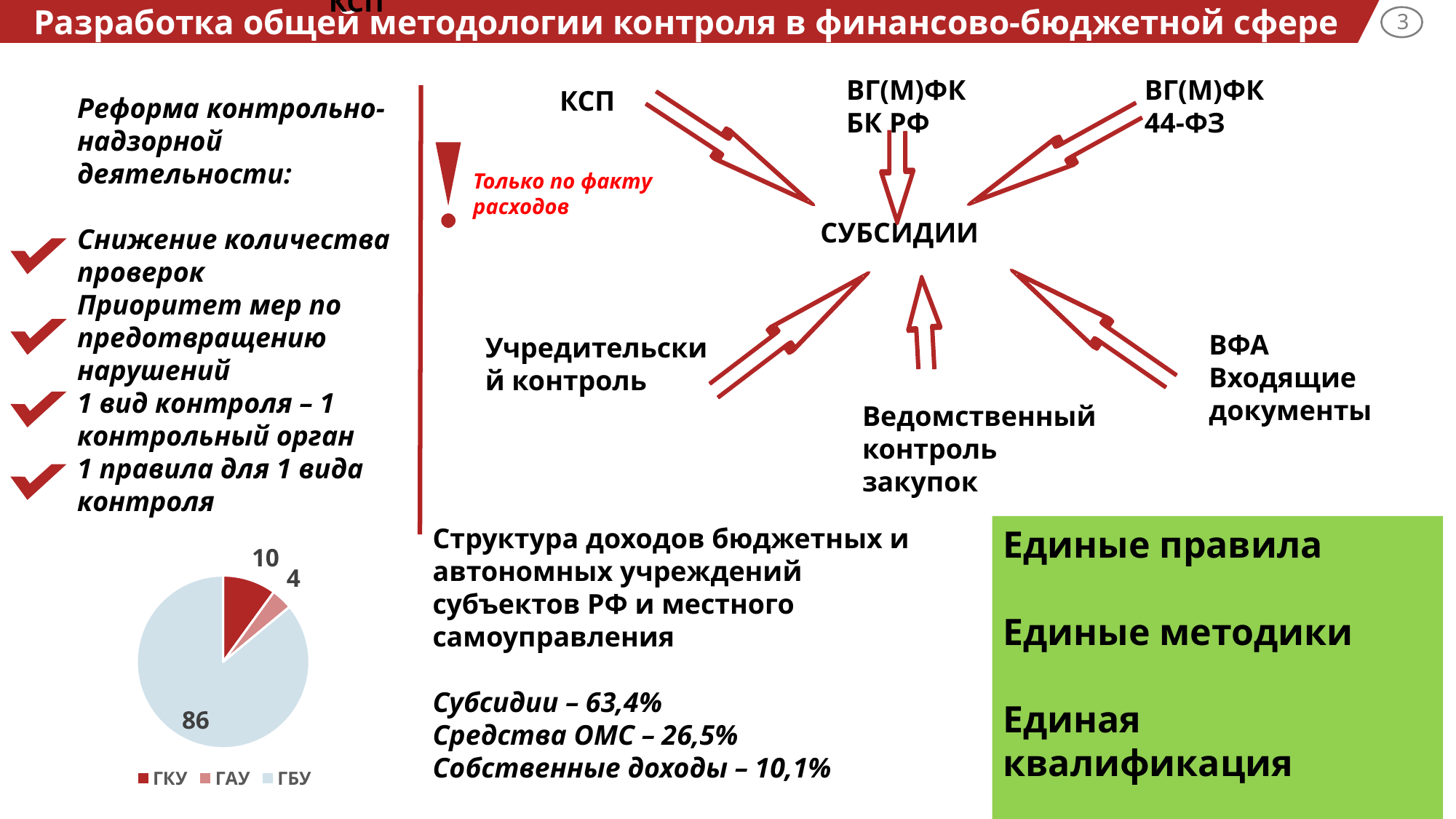
What colour is the ГБУ slice in the pie chart? light blue In the pie chart, what is the value for ГАУ? 4 How many slices does the pie chart have? 3 In the pie chart, what is the difference between the values for ГБУ and ГКУ? 76 What is the total of all the values shown in the pie chart? 100 In the pie chart, what is the value for ГКУ? 10 In the pie chart, what is the value for ГБУ? 86 In the pie chart, which is larger, the value for ГКУ or the value for ГАУ? ГКУ Which category has the largest slice in the pie chart? ГБУ Which category has the smallest slice in the pie chart? ГАУ What kind of chart is shown at the bottom left of the slide? pie chart How many entries does the legend of the pie chart list? 3